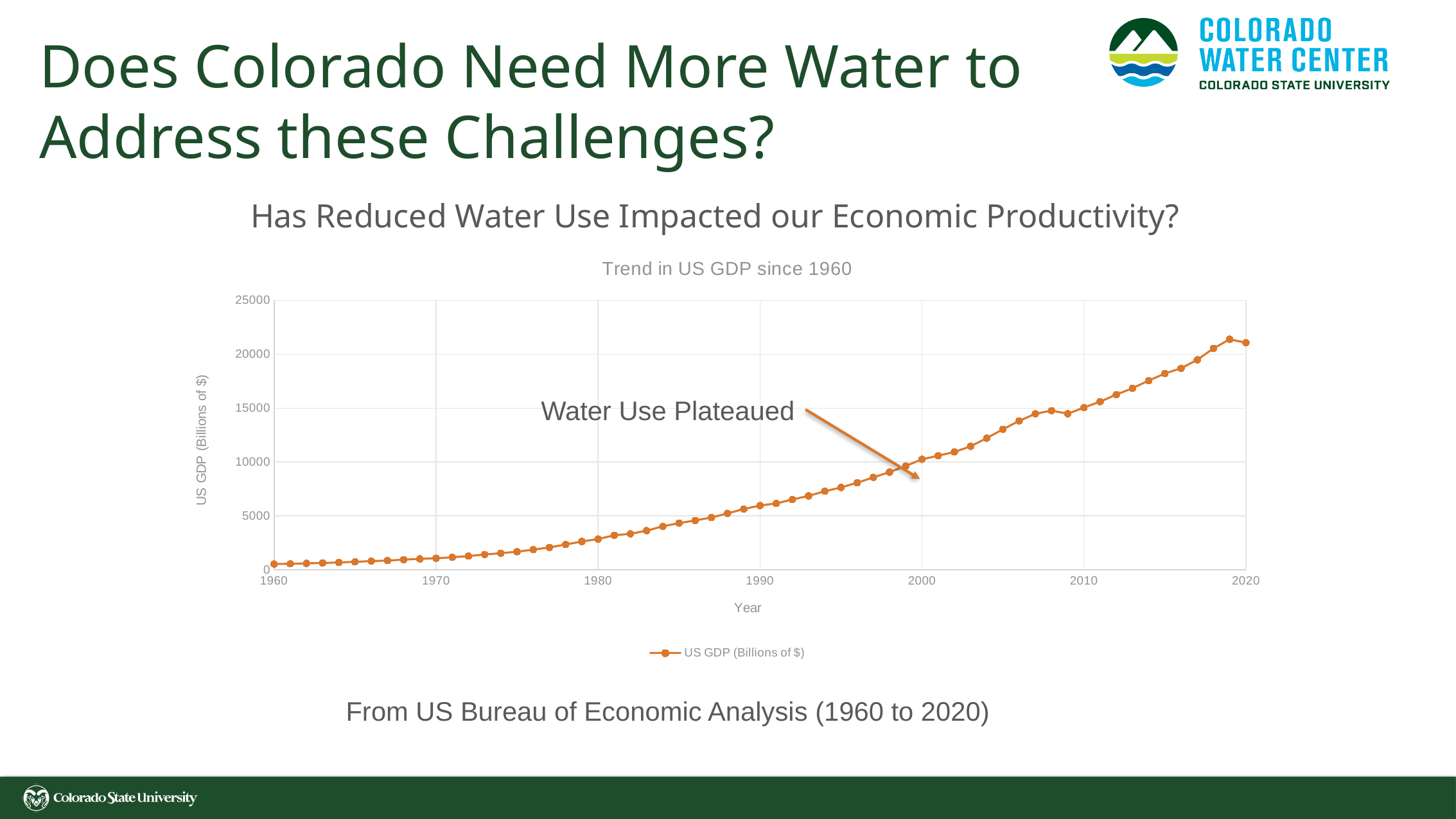
Is the US GDP value for 1990 greater or less than 5000? greater Which year has the larger US GDP value, 1990 or 2010? 2010 Do the US GDP values generally rise or fall from 1960 to 2020? rise What kind of chart is shown on the slide? line chart What is the label of the series in the chart legend? US GDP (Billions of $) What is the title of the chart? Trend in US GDP since 1960 Is the US GDP value for 2020 greater or less than 20000? greater Is the US GDP value for 2005 greater or less than 15000? less How many series does the chart legend list? 1 Which year has the lowest US GDP value on the chart? 1960